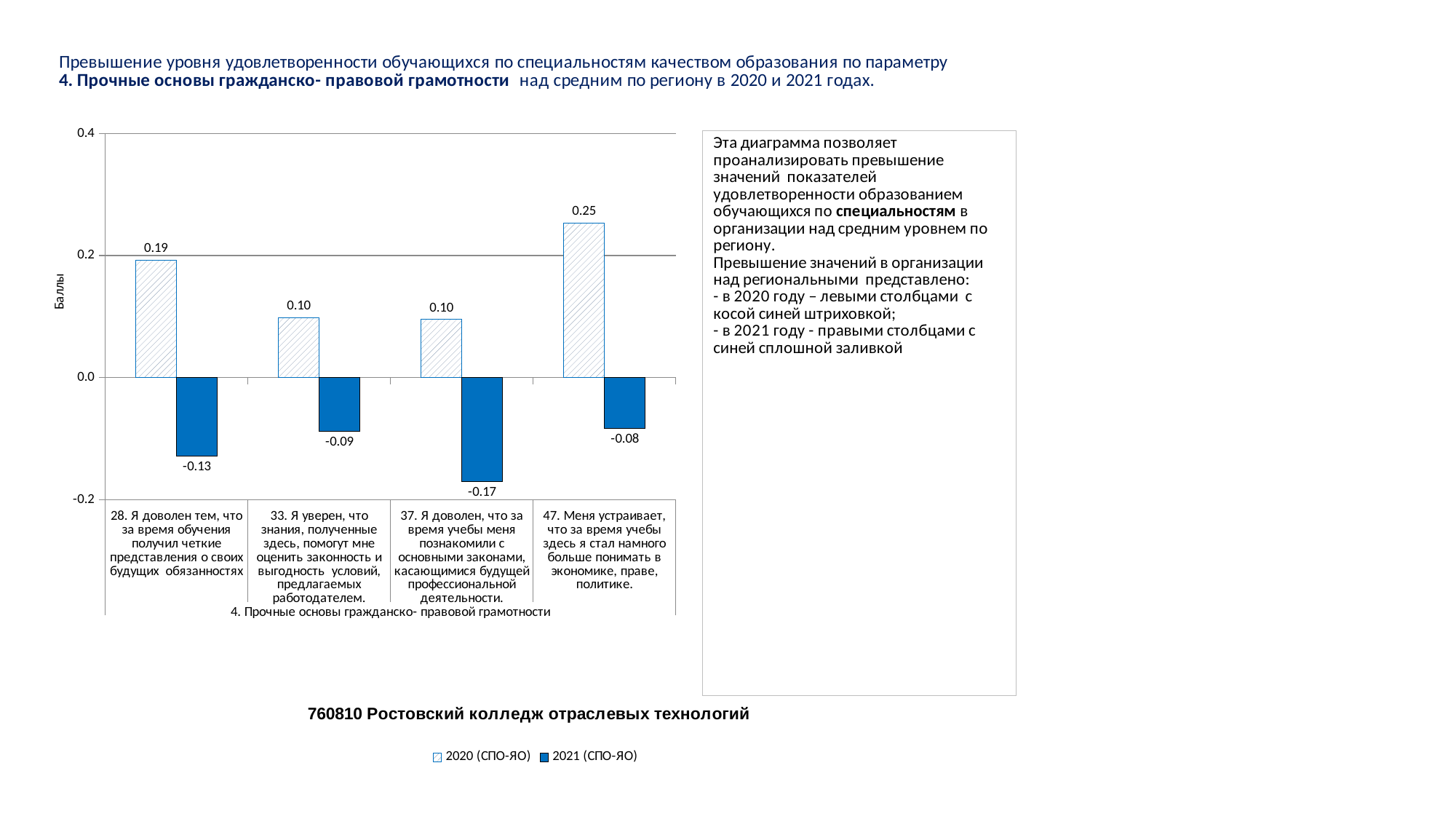
What is the difference between the 2020 (СПО-ЯО) values for category 47 and category 28? 0.06 What kind of chart is shown on the slide? Bar chart How many series does the legend list? 2 How many categories are shown on the x axis of the chart? 4 Which is larger: the 2021 (СПО-ЯО) value for category 33 or for category 47? Category 47 (-0.08) What is the label of the vertical axis of the chart? Баллы What is the 2020 (СПО-ЯО) value for category 47 (Меня устраивает, что за время учебы здесь я стал намного больше понимать в экономике, праве, политике)? 0.25 What is the 2021 (СПО-ЯО) value for category 37 (Я доволен, что за время учебы меня познакомили с основными законами)? -0.17 Which category has the lowest 2021 (СПО-ЯО) value? 37. Я доволен, что за время учебы меня познакомили с основными законами, касающимися будущей профессиональной деятельности. What is the 2021 (СПО-ЯО) value for category 28 (Я доволен тем, что за время обучения получил четкие представления о своих будущих обязанностях)? -0.13 Is the 2020 (СПО-ЯО) value for category 47 greater or less than 0.2? greater Which category has the highest 2020 (СПО-ЯО) value? 47. Меня устраивает, что за время учебы здесь я стал намного больше понимать в экономике, праве, политике.